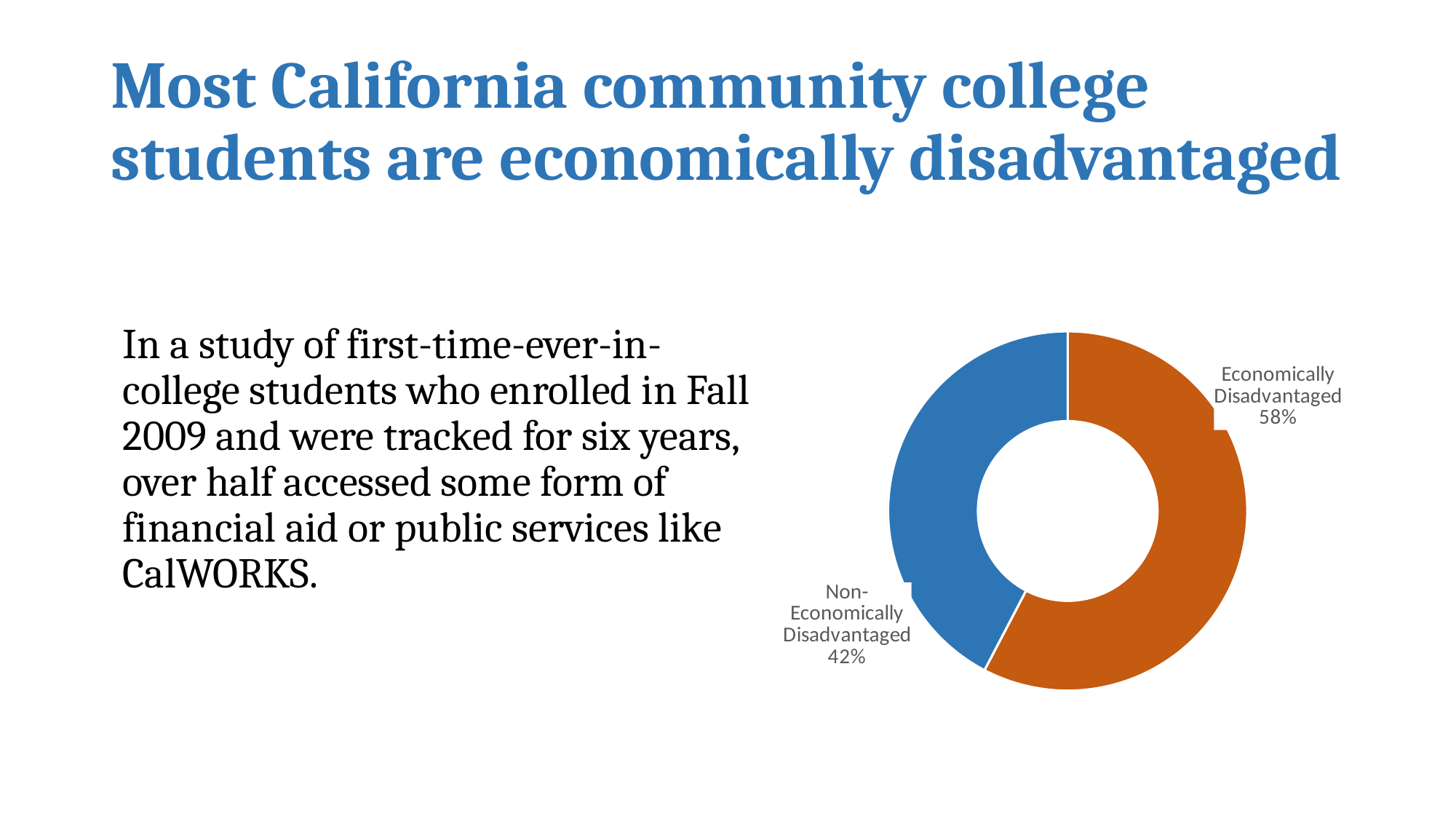
Which category has the smaller share of the chart? Non-Economically Disadvantaged What share of students are Non-Economically Disadvantaged? 42% What colour is the Economically Disadvantaged segment? orange What colour is the Non-Economically Disadvantaged segment? blue What kind of chart is shown on the slide? doughnut (pie) chart What is the difference in percentage points between the Economically Disadvantaged and Non-Economically Disadvantaged shares? 16 percentage points What share of students are Economically Disadvantaged? 58% Is the share for Economically Disadvantaged larger or smaller than the share for Non-Economically Disadvantaged? larger Is the share for Economically Disadvantaged greater or less than 50%? greater Which category has the larger share of the chart? Economically Disadvantaged How many categories does the chart show? 2